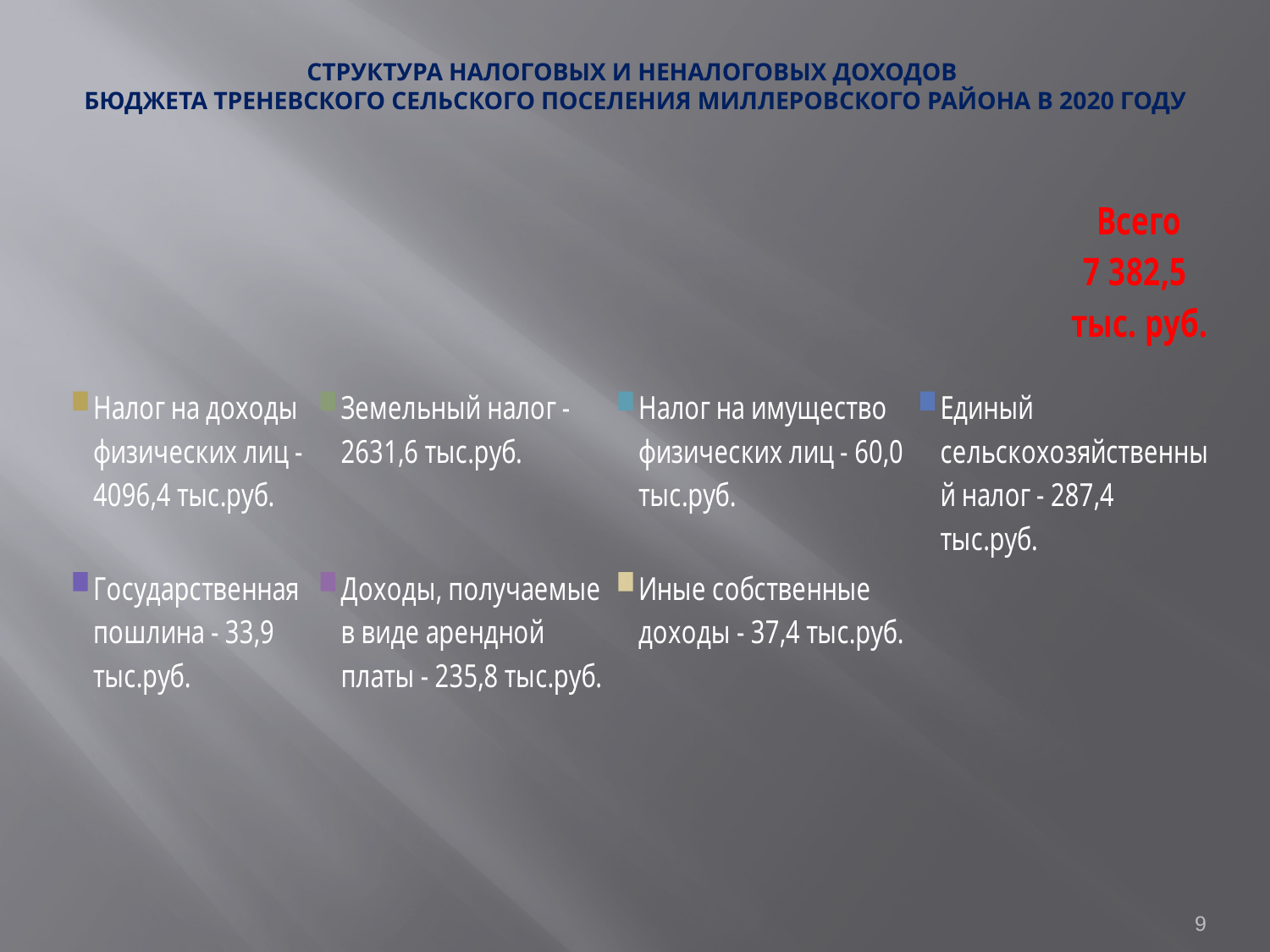
How many categories does the chart legend list? 7 What total (Всего) is shown on the slide for the chart? 7 382,5 тыс. руб. According to the chart legend, what is the value for Земельный налог? 2631,6 тыс.руб. According to the chart legend, what is the value for Налог на доходы физических лиц? 4096,4 тыс.руб. Which is larger according to the legend: Единый сельскохозяйственный налог or Доходы, получаемые в виде арендной платы? Единый сельскохозяйственный налог According to the chart legend, what is the value for Иные собственные доходы? 37,4 тыс.руб. Which category in the chart legend has the lowest value? Государственная пошлина According to the chart legend, what is the value for Государственная пошлина? 33,9 тыс.руб. According to the chart legend, what is the value for Единый сельскохозяйственный налог? 287,4 тыс.руб. According to the chart legend, what is the value for Доходы, получаемые в виде арендной платы? 235,8 тыс.руб. Which category in the chart legend has the highest value? Налог на доходы физических лиц According to the chart legend, what is the value for Налог на имущество физических лиц? 60,0 тыс.руб.